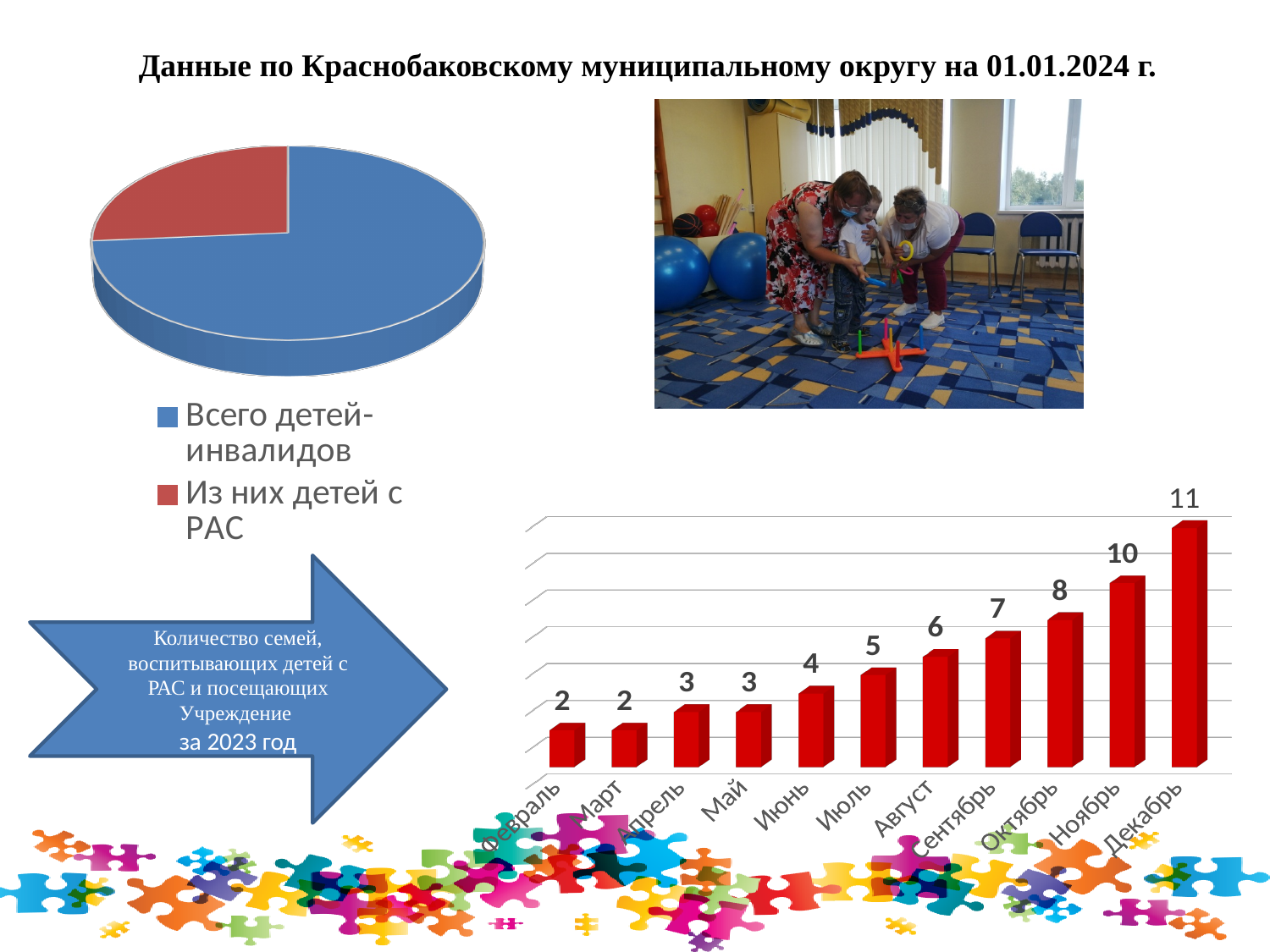
What kind of chart is the chart at the top left of the slide? pie chart In the bar chart at the bottom right, which is larger, the value for Август or the value for Май? Август In the bar chart at the bottom right, do the values rise or fall from Февраль to Декабрь? rise What kind of chart is the chart at the bottom right of the slide? bar chart In the bar chart at the bottom right, what is the value for Ноябрь? 10 In the pie chart at the top left, how many entries does the legend list? 2 In the bar chart at the bottom right, how many months are shown on the x axis? 11 In the bar chart at the bottom right, what is the difference between the values for Декабрь and Февраль? 9 In the pie chart at the top left, which slice is larger, 'Всего детей-инвалидов' or 'Из них детей с РАС'? Всего детей-инвалидов In the bar chart at the bottom right, what is the value for Июнь? 4 In the bar chart at the bottom right, what is the value for Декабрь? 11 In the bar chart at the bottom right, which month has the highest value? Декабрь